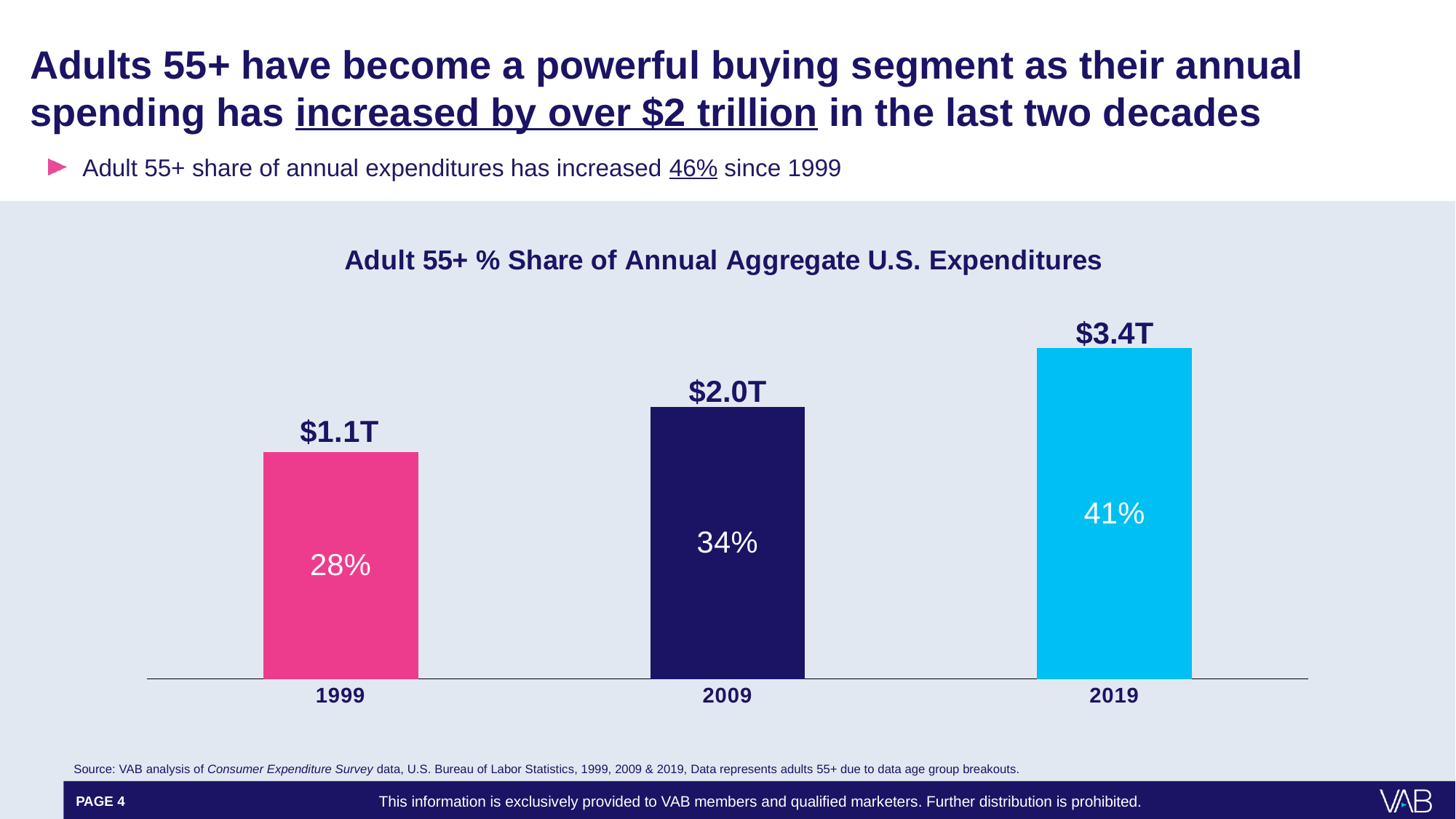
What is the Adult 55+ share of annual aggregate U.S. expenditures in 2009? 34% Do the values rise or fall from 1999 to 2019? Rise What is the Adult 55+ share of annual aggregate U.S. expenditures in 2019? 41% How many years are shown on the chart? 3 What dollar amount is labelled above the 1999 bar? $1.1T What dollar amount is labelled above the 2019 bar? $3.4T What is the Adult 55+ share of annual aggregate U.S. expenditures in 1999? 28% Which year has the lowest Adult 55+ share of annual aggregate U.S. expenditures? 1999 What is the difference in percentage points between the 2019 share and the 1999 share? 13 percentage points Which year has a larger share, 2009 or 1999? 2009 What kind of chart is shown on the slide? Bar chart Which year has the highest Adult 55+ share of annual aggregate U.S. expenditures? 2019